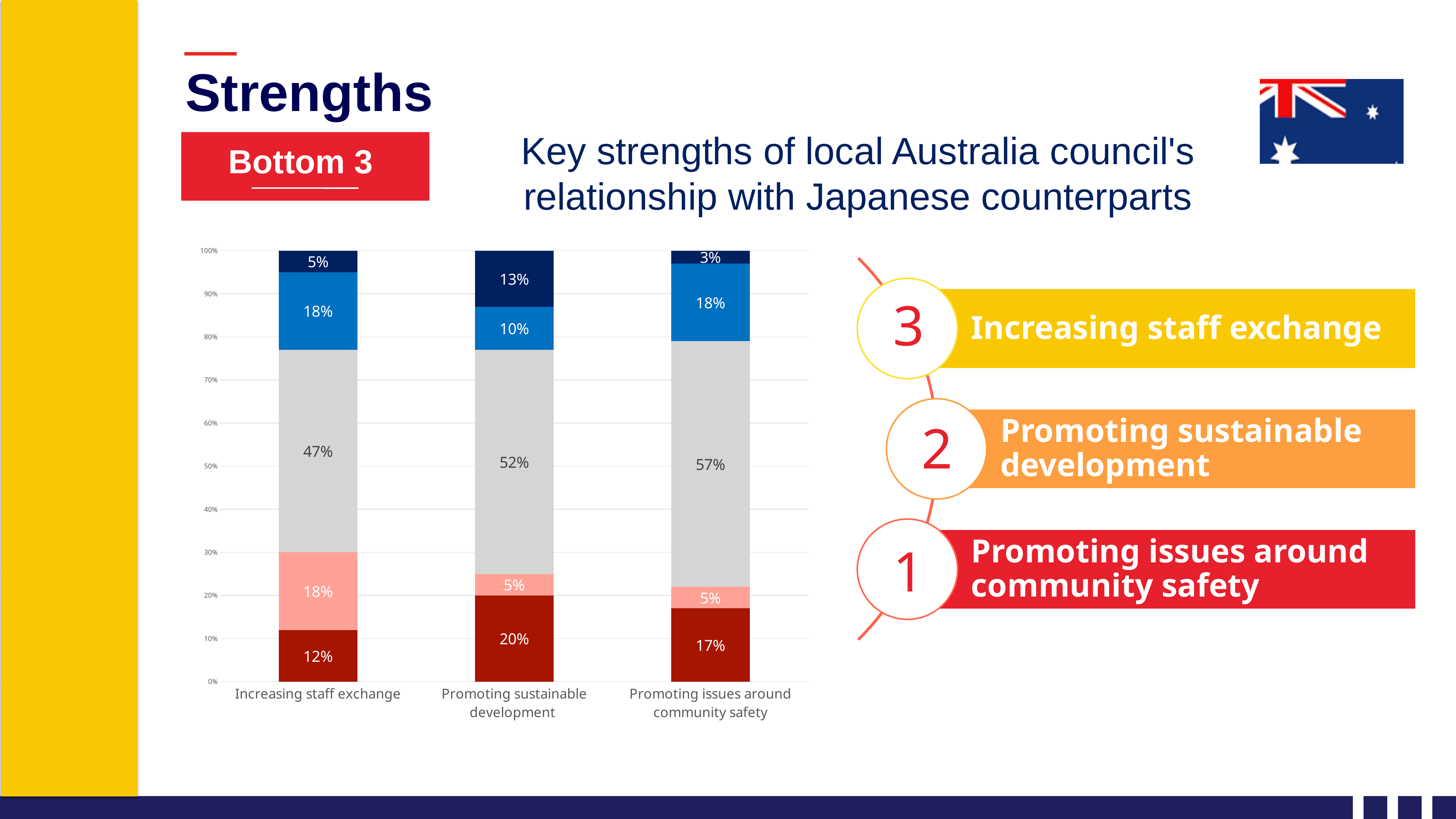
What is the value of the grey segment for Promoting issues around community safety? 57% What is the value of the dark navy top segment for Increasing staff exchange? 5% What is the difference between the grey segment for Promoting issues around community safety and the grey segment for Increasing staff exchange? 10% Which category has the smallest dark navy top segment? Promoting issues around community safety What is the value of the dark red bottom segment for Promoting sustainable development? 20% What kind of chart is shown on the slide? Stacked bar chart What is the value of the light pink segment for Increasing staff exchange? 18% What is the combined value of the blue and dark navy segments for Promoting sustainable development? 23% How many categories are shown on the x axis of the chart? 3 Is the dark red bottom segment larger for Promoting sustainable development or for Increasing staff exchange? Promoting sustainable development Which category has the largest grey segment? Promoting issues around community safety What is the title text above the chart? Key strengths of local Australia council's relationship with Japanese counterparts